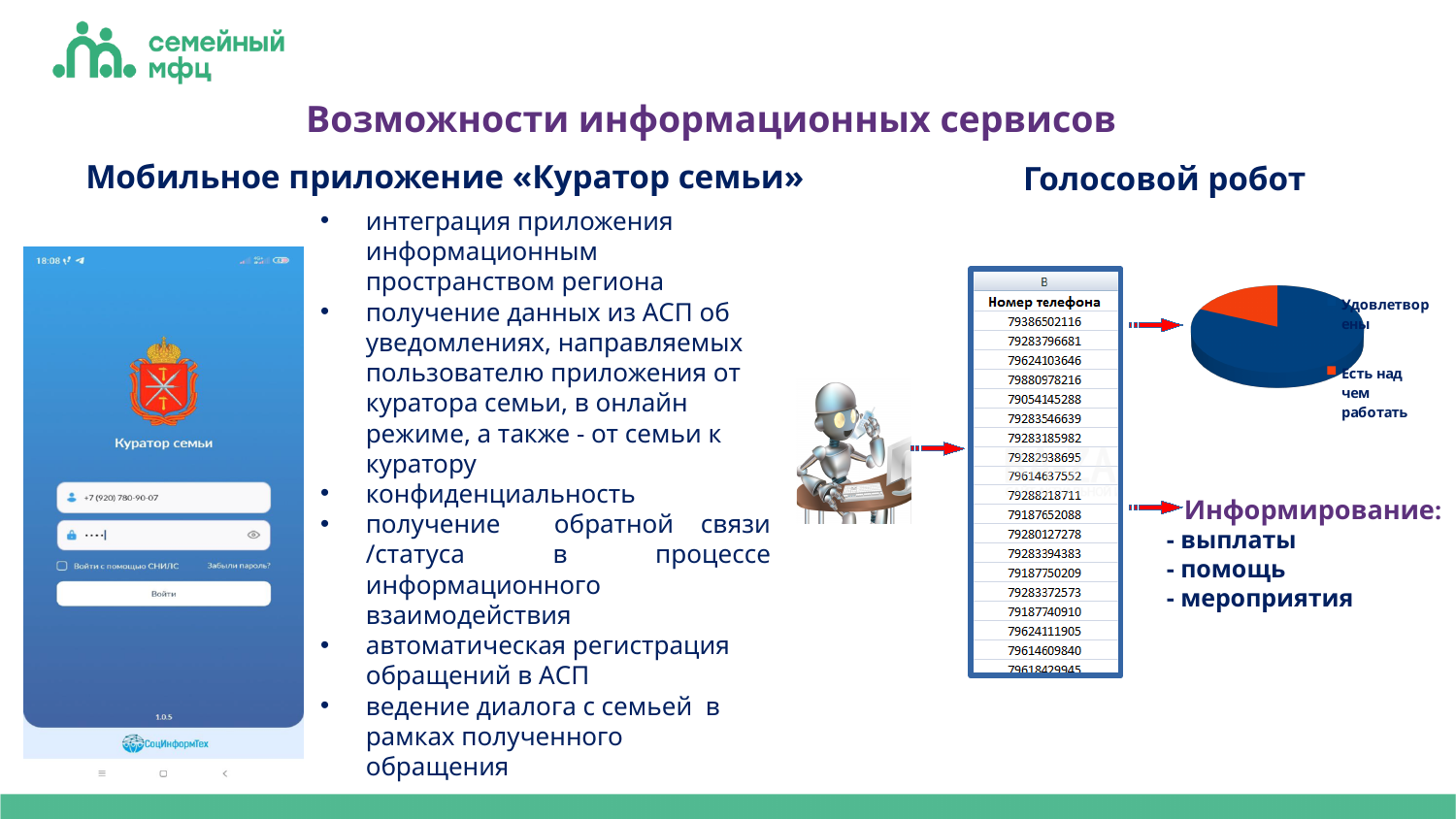
In the pie chart, which is larger: "Удовлетворены" or "Есть над чем работать"? Удовлетворены What colour is the "Удовлетворены" slice in the pie chart? blue Which slice of the pie chart is the largest? Удовлетворены What kind of chart is shown on the right side of the slide under "Голосовой робот"? pie chart How many slices does the pie chart have? 2 Does the "Удовлетворены" slice take up more or less than half of the pie chart? more Which slice of the pie chart is the smallest? Есть над чем работать What colour is the "Есть над чем работать" slice in the pie chart? orange-red